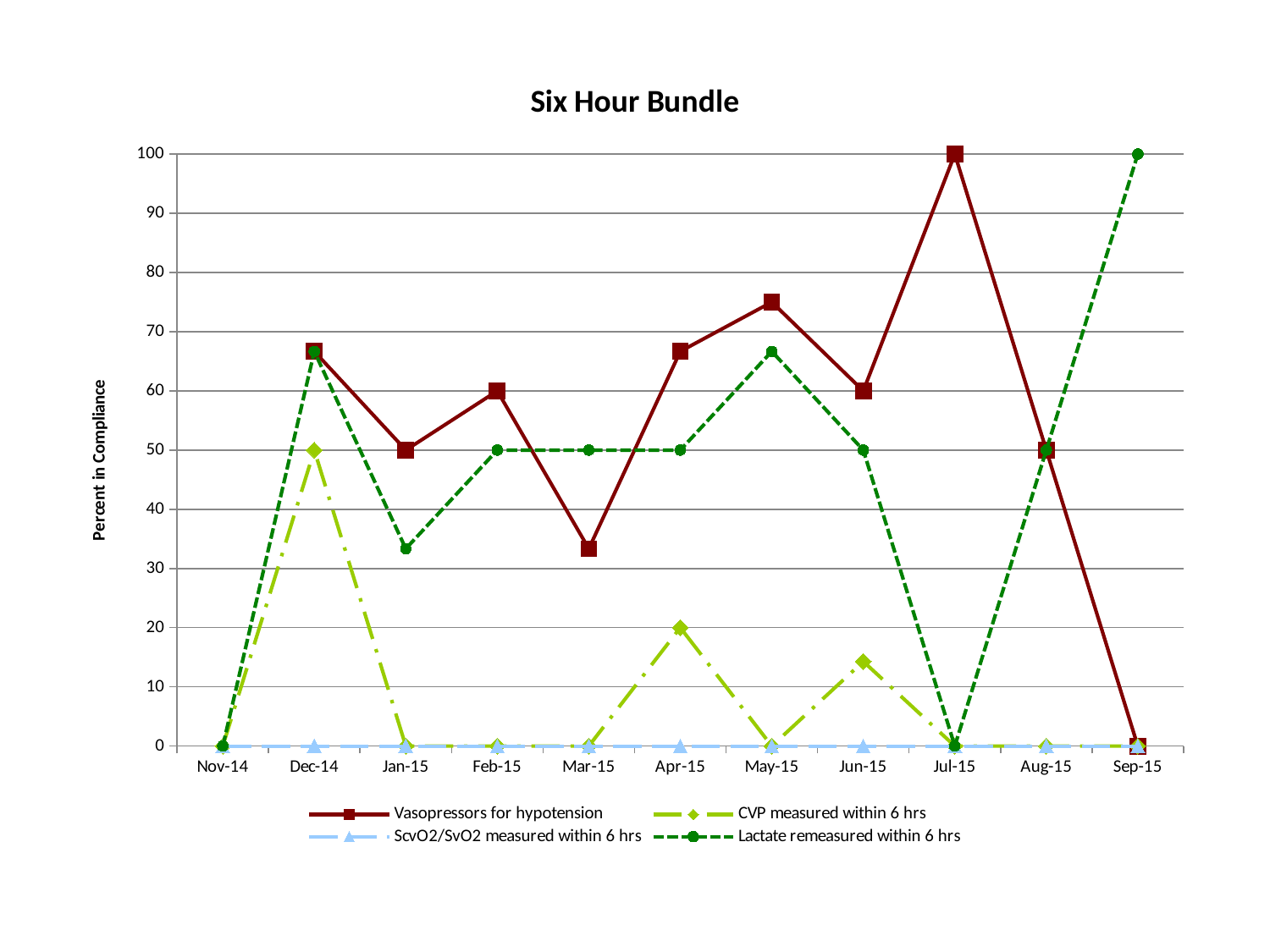
What is the title of the chart? Six Hour Bundle Which is larger in Mar-15, Vasopressors for hypotension or Lactate remeasured within 6 hrs? Lactate remeasured within 6 hrs How many months are shown along the x axis? 11 In which month is Vasopressors for hypotension highest? Jul-15 What is the value for CVP measured within 6 hrs in Apr-15? 20 What is the value for Vasopressors for hypotension in Feb-15? 60 Is the value for Vasopressors for hypotension in May-15 greater or less than 70? greater What is the difference between Vasopressors for hypotension in Jul-15 and in Aug-15? 50 What kind of chart is shown on the slide? line chart How many series does the legend list? 4 What is the value for Vasopressors for hypotension in Jul-15? 100 What is the value for Lactate remeasured within 6 hrs in Sep-15? 100